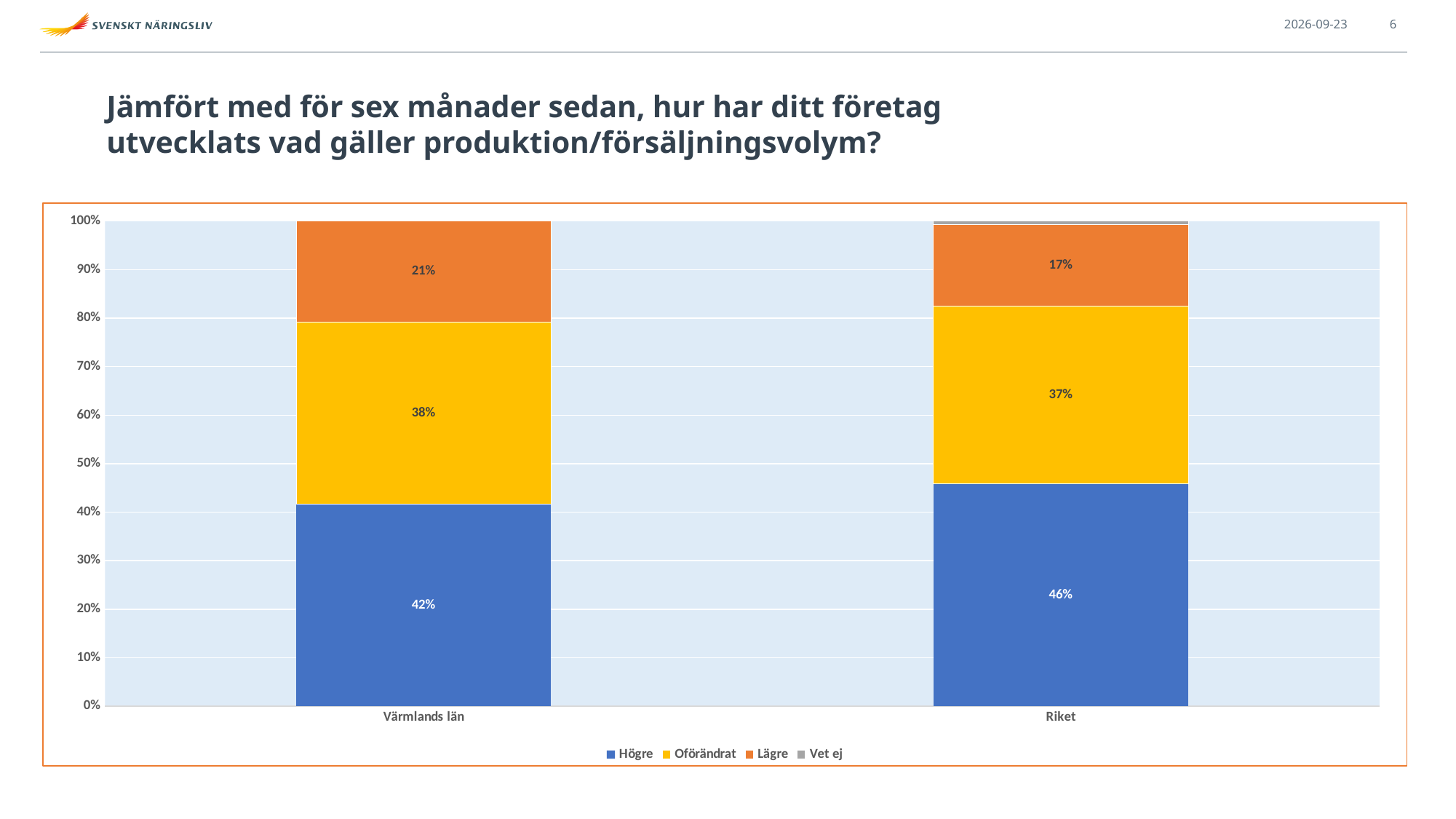
Which category has the higher value for Högre, Värmlands län or Riket? Riket Which category has the higher value for Lägre, Värmlands län or Riket? Värmlands län What is the difference between the Lägre values for Värmlands län and Riket? 4% How many series does the legend list? 4 What kind of chart is shown on the slide? Stacked bar chart What is the value for Högre in Värmlands län? 42% Which series has the largest share in the Värmlands län bar? Högre What is the value for Oförändrat in Riket? 37% What is the difference between the Högre values for Riket and Värmlands län? 4% How many categories are shown on the x axis? 2 What is the value for Högre in Riket? 46% What is the value for Lägre in Värmlands län? 21%